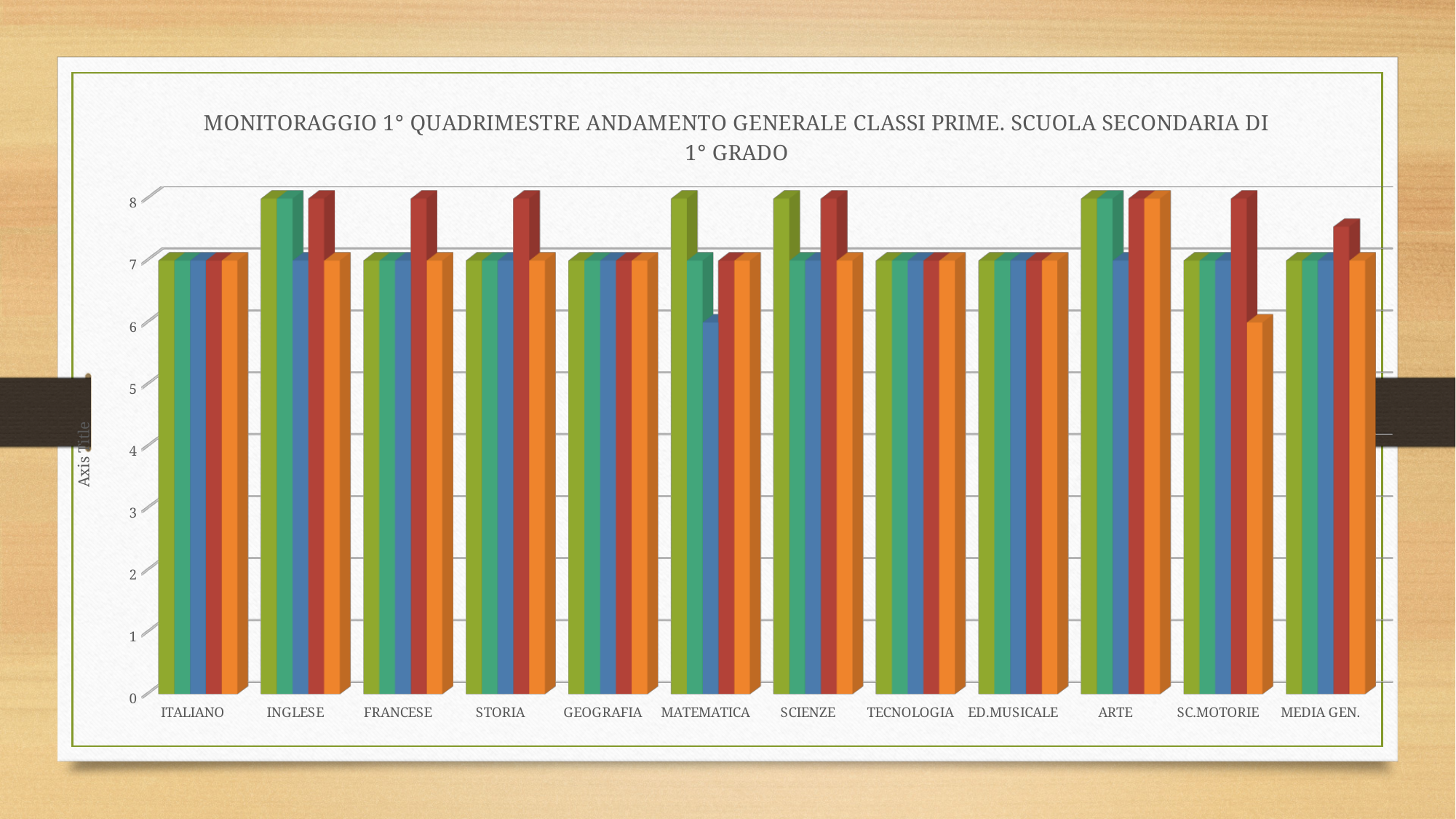
Which category has the lowest blue bar? MATEMATICA What is the value of the orange bar for ARTE? 8 What is the value of the green bar for INGLESE? 8 Which category has the lowest orange bar? SC.MOTORIE What is the title of the chart? MONITORAGGIO 1° QUADRIMESTRE ANDAMENTO GENERALE CLASSI PRIME. SCUOLA SECONDARIA DI 1° GRADO How many subject categories are shown on the x axis? 12 What is the value of the orange bar for SC.MOTORIE? 6 For MATEMATICA, which is larger: the green bar or the blue bar? the green bar What is the value of the green bar for ITALIANO? 7 What is the value of the blue bar for MATEMATICA? 6 Is the value of the red bar for MEDIA GEN. greater or less than 7? greater What kind of chart is shown on the slide? bar chart